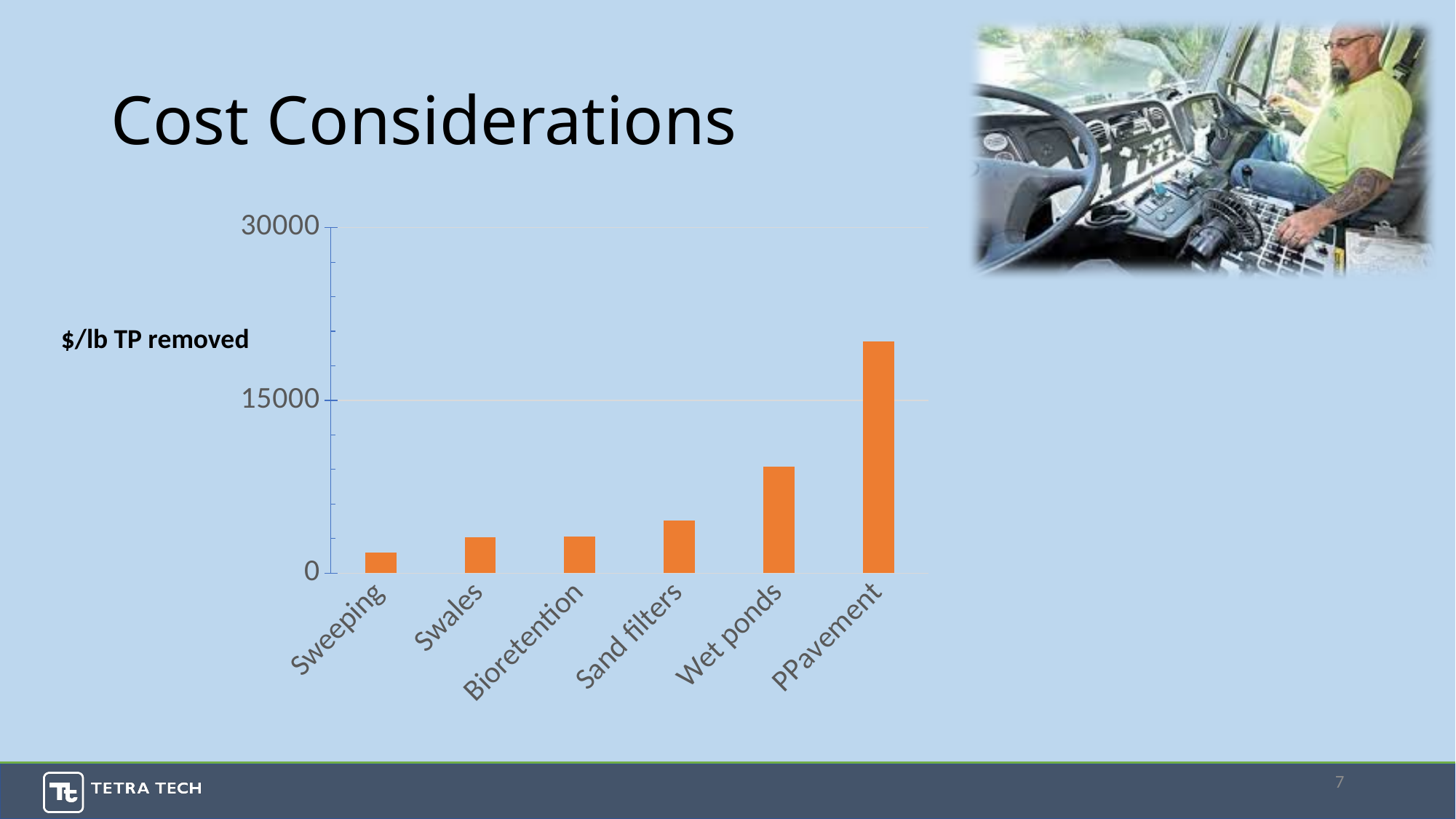
Which is larger, the value for Wet ponds or the value for Sand filters? Wet ponds Which category has the highest value on the chart? PPavement What is the title of the slide containing the chart? Cost Considerations Do the values generally rise or fall moving from left to right along the x axis? rise Is the value for PPavement greater or less than 15000? greater How many categories are plotted on the chart? 6 Is the value for PPavement greater or less than 30000? less Which category has the lowest value on the chart? Sweeping Which is larger, the value for Sweeping or the value for Swales? Swales Is the value for Wet ponds greater or less than 15000? less What kind of chart is shown on the slide? bar chart What unit label is shown next to the vertical axis of the chart? $/lb TP removed